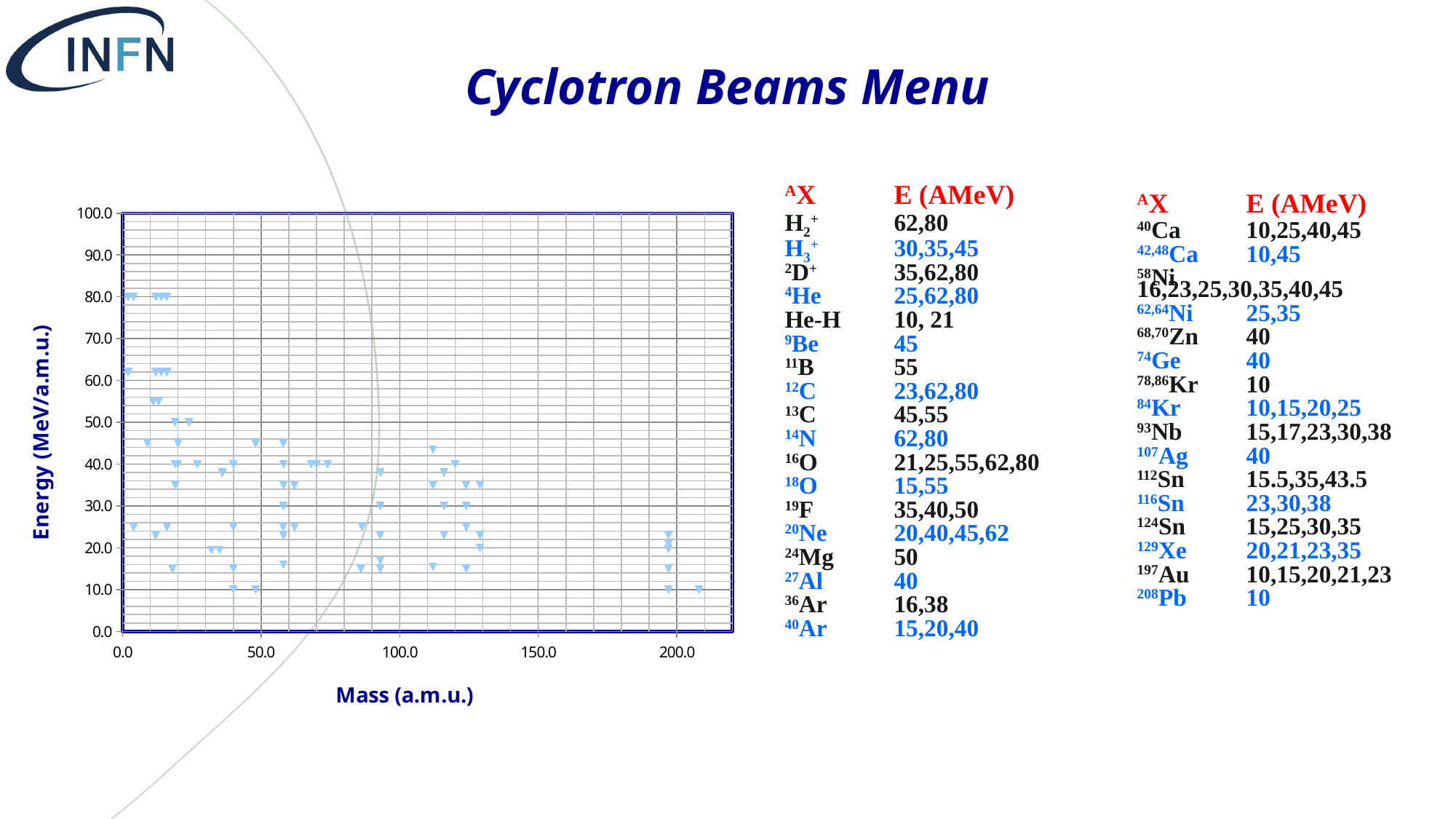
Is the highest energy value plotted on the chart greater or less than 90? less What is the maximum value shown on the y axis of the chart? 100.0 Is the highest energy value plotted on the chart greater or less than 70? greater Are the highest energy values on the chart found at low masses (below 50 a.m.u.) or at high masses (above 150 a.m.u.)? low masses (below 50 a.m.u.) What kind of chart is shown on the slide? scatter chart Are the energy values plotted at a mass of about 200 a.m.u. greater or less than 30? less What is the title of the x axis of the chart? Mass (a.m.u.) What is the title of the y axis of the chart? Energy (MeV/a.m.u.)